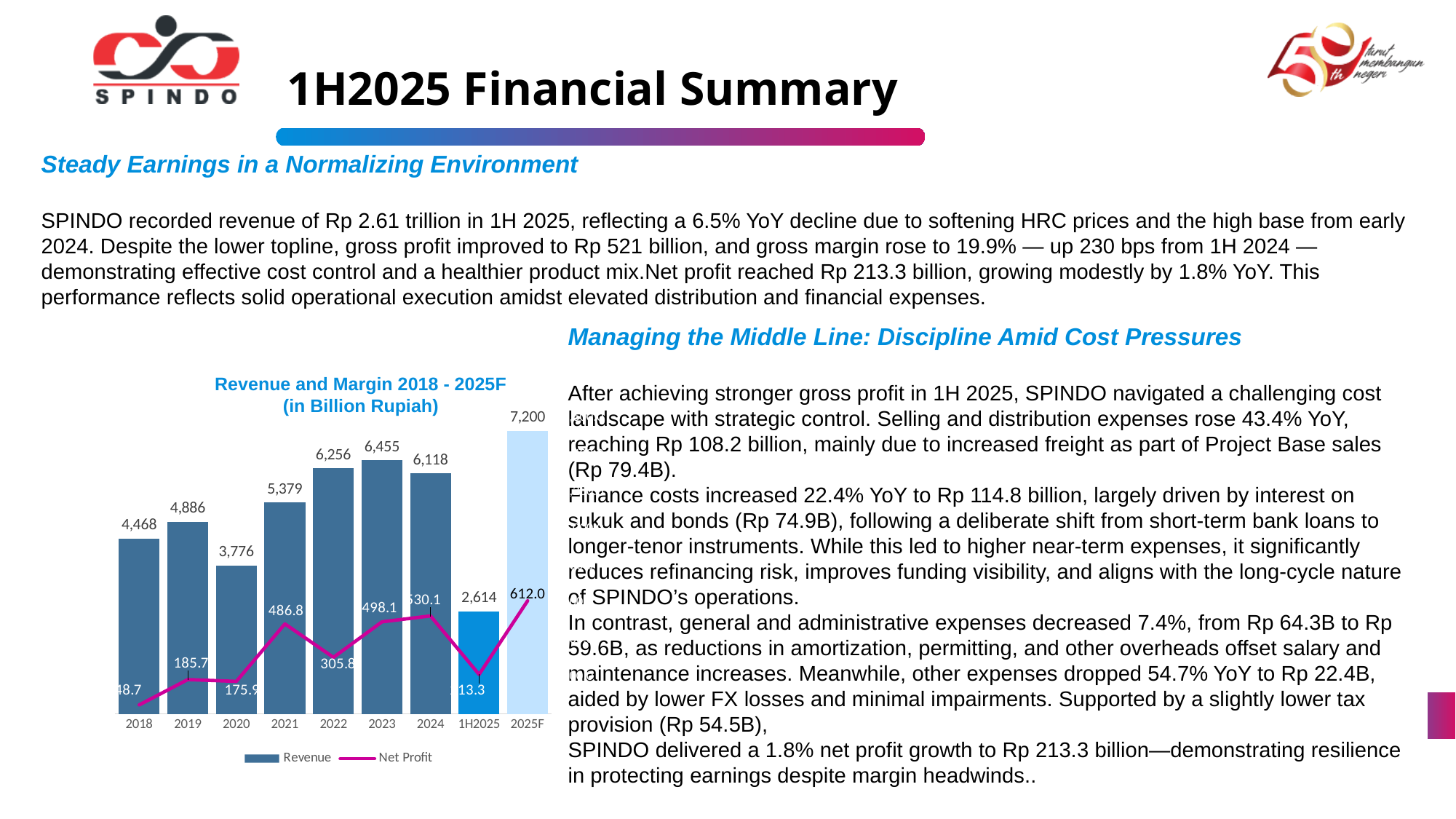
What is the difference between the revenue for 2023 and the revenue for 2022? 199 What is the revenue value shown for 2023? 6,455 Which year has the highest revenue bar? 2025F How many periods are shown on the x axis of the chart? 9 What is the Net Profit value shown for 2021? 486.8 What kind of chart is used to show revenue? bar chart (with a line for Net Profit) Which period has the lowest revenue bar? 1H2025 What is the revenue value shown for 2020? 3,776 Does revenue rise or fall from 2020 to 2023? rise How many series does the legend list? 2 Which is larger, the revenue for 2021 or the revenue for 2019? 2021 What is the Net Profit value shown for 2025F? 612.0